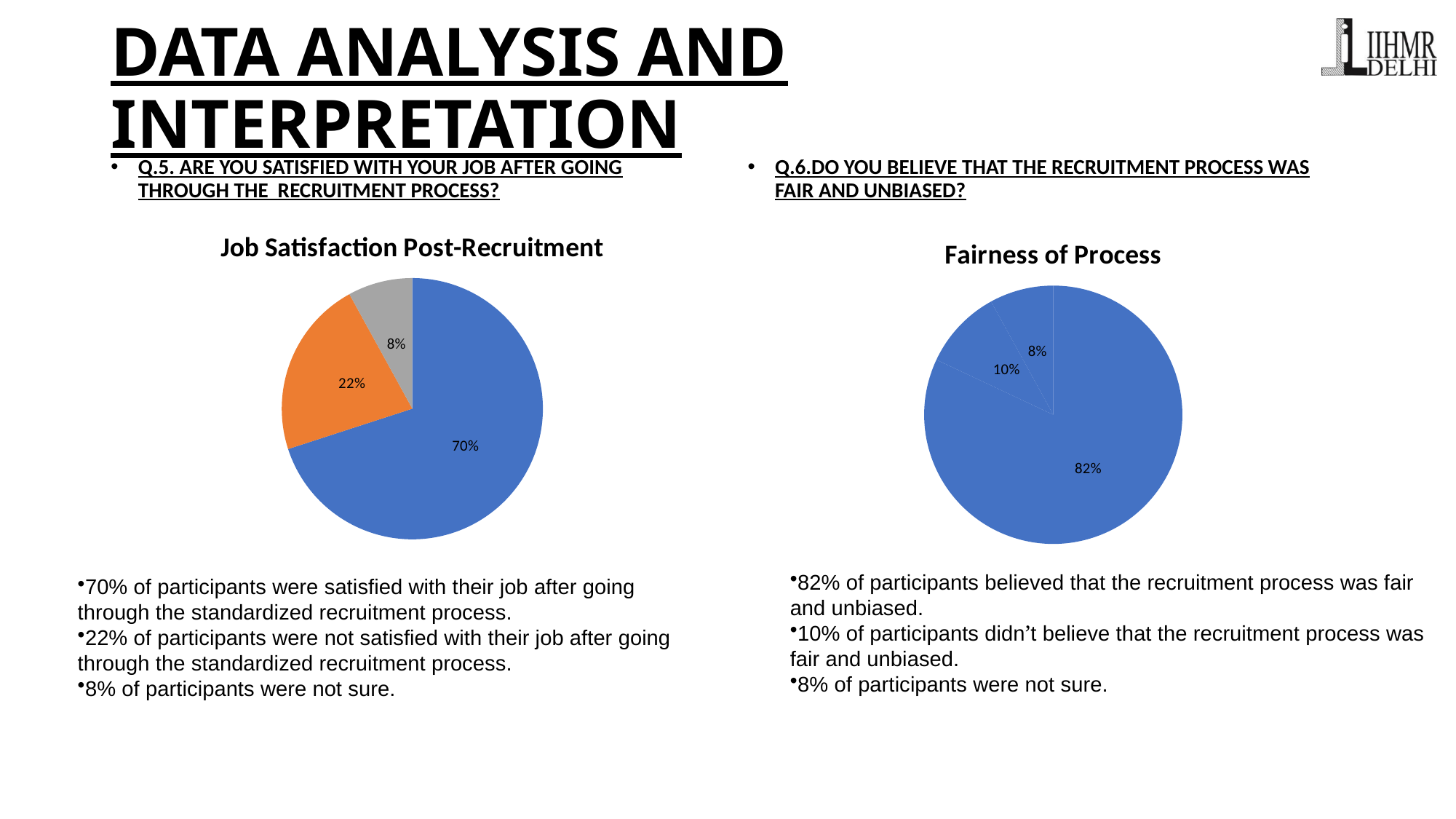
In the "Job Satisfaction Post-Recruitment" chart, what share does the smallest slice have? 8% What kind of chart is the "Fairness of Process" chart? pie chart In the "Job Satisfaction Post-Recruitment" chart, what is the difference between the largest slice and the orange slice? 48% In the "Fairness of Process" chart, what is the difference between the 82% slice and the 10% slice? 72% In the "Fairness of Process" chart, what share does the largest slice have? 82% In the "Job Satisfaction Post-Recruitment" chart, what share does the orange slice have? 22% How many slices does the "Job Satisfaction Post-Recruitment" pie chart have? 3 In the "Job Satisfaction Post-Recruitment" chart, what share does the largest slice have? 70% What kind of chart is the "Job Satisfaction Post-Recruitment" chart? pie chart Which chart has the larger biggest slice, "Job Satisfaction Post-Recruitment" or "Fairness of Process"? Fairness of Process How many slices does the "Fairness of Process" pie chart have? 3 In the "Fairness of Process" chart, what share does the smallest slice have? 8%